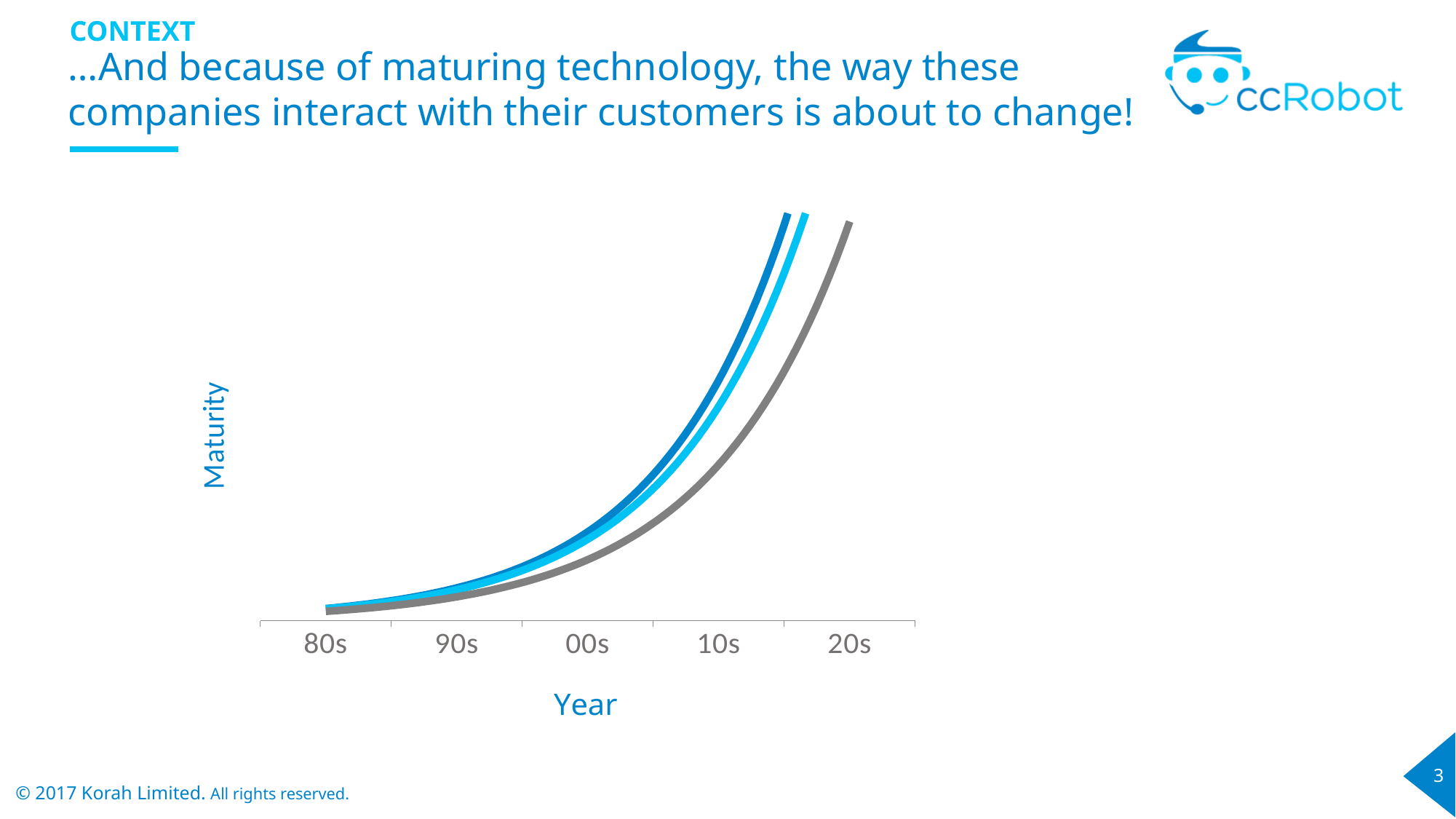
What is the label of the y axis on the chart? Maturity Which decade is the last category on the x axis of the chart? 20s What kind of chart is shown on the slide? line chart At the 10s, is the dark blue line higher or lower than the gray line? higher At the 10s, which line is highest on the chart: the dark blue, the light blue, or the gray line? dark blue How many lines are plotted on the chart? 3 How many decade categories are labelled on the x axis of the chart? 5 At the 10s, which line is lowest on the chart: the dark blue, the light blue, or the gray line? gray Do the lines on the chart rise or fall as the years move from the 80s to the 20s? rise What is the label of the x axis on the chart? Year Which decade is the first category on the x axis of the chart? 80s